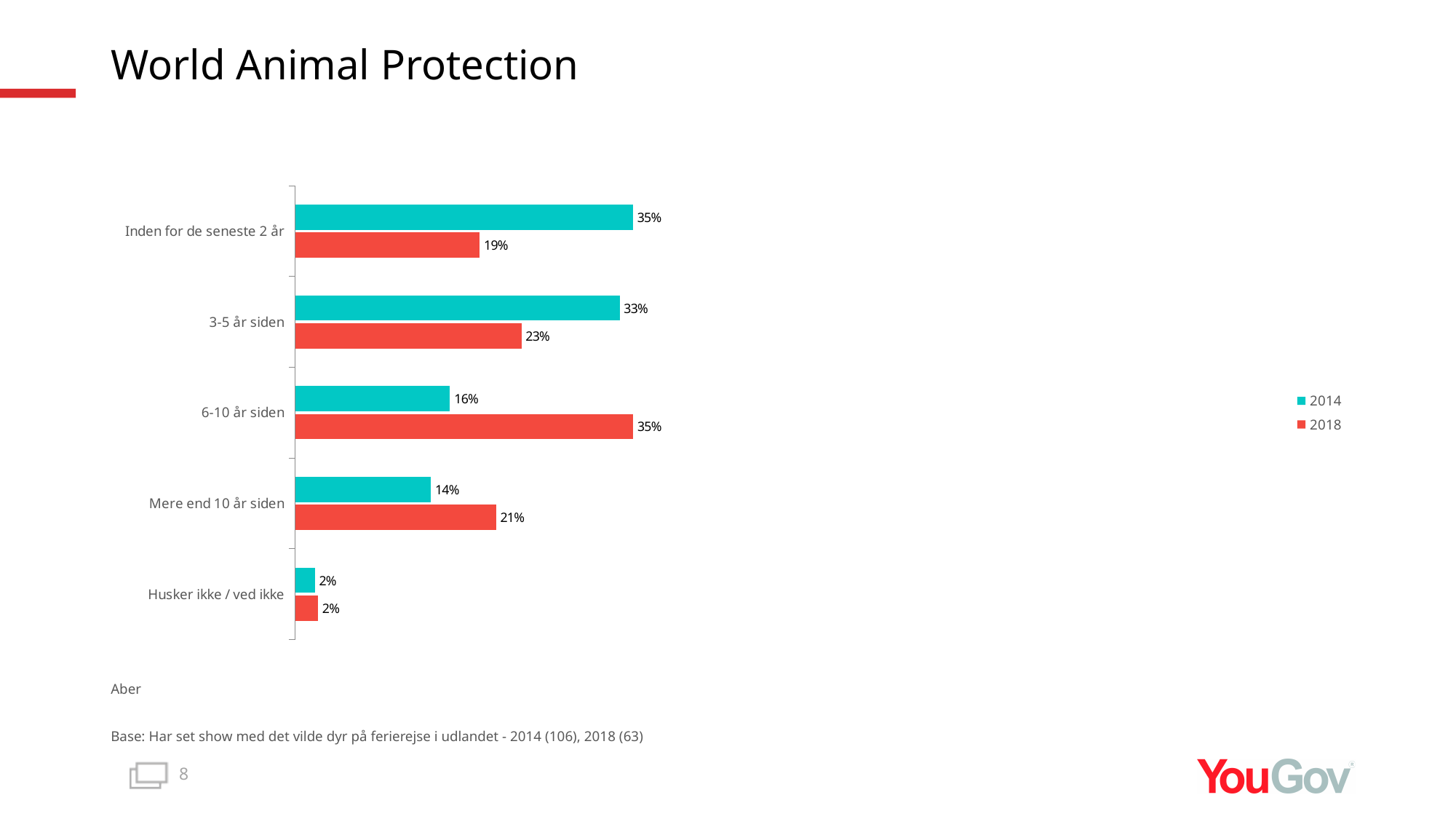
What is the difference between the 2014 and 2018 values for "Inden for de seneste 2 år"? 16% What is the 2018 value for "3-5 år siden"? 23% What is the 2014 value for "Inden for de seneste 2 år"? 35% What kind of chart is shown on the slide? Bar chart Which category has the highest 2018 value? 6-10 år siden What is the difference between the 2018 and 2014 values for "6-10 år siden"? 19% What is the 2018 value for "Mere end 10 år siden"? 21% How many categories are shown on the chart? 5 How many series does the legend list? 2 Which category has the lowest 2014 value? Husker ikke / ved ikke Which colour represents the 2018 series in the legend? Red For "3-5 år siden", which series has the larger value, 2014 or 2018? 2014